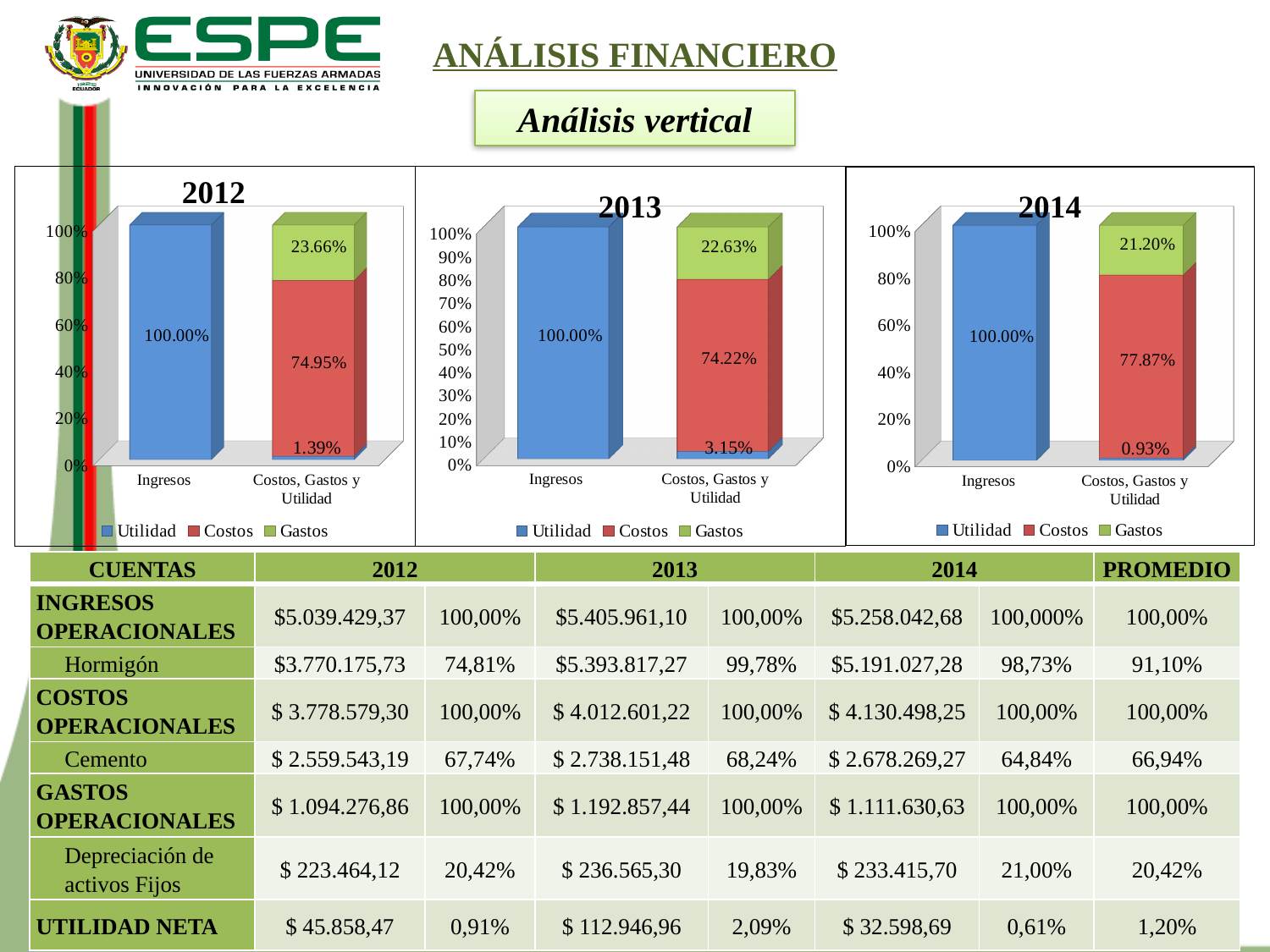
In the 2014 chart, what is the value shown for Ingresos? 100.00% What is the title of the leftmost chart? 2012 In the 2013 chart, what is the value of the Gastos segment? 22.63% In the 2013 chart, which segment of the Costos, Gastos y Utilidad bar is the smallest? Utilidad In the 2012 chart, what is the value of the Costos segment in the Costos, Gastos y Utilidad bar? 74.95% How many categories are shown on the x axis of the 2013 chart? 2 What type of chart is the 2014 chart? Stacked bar chart In the 2014 chart, what is the value of the Utilidad segment? 0.93% In the 2014 chart, what is the difference between the Costos and Gastos segments? 56.67% In the 2012 chart, which segment of the Costos, Gastos y Utilidad bar is the largest? Costos Is the Costos segment larger in the 2014 chart or in the 2013 chart? 2014 How many series does the legend of the 2012 chart list? 3